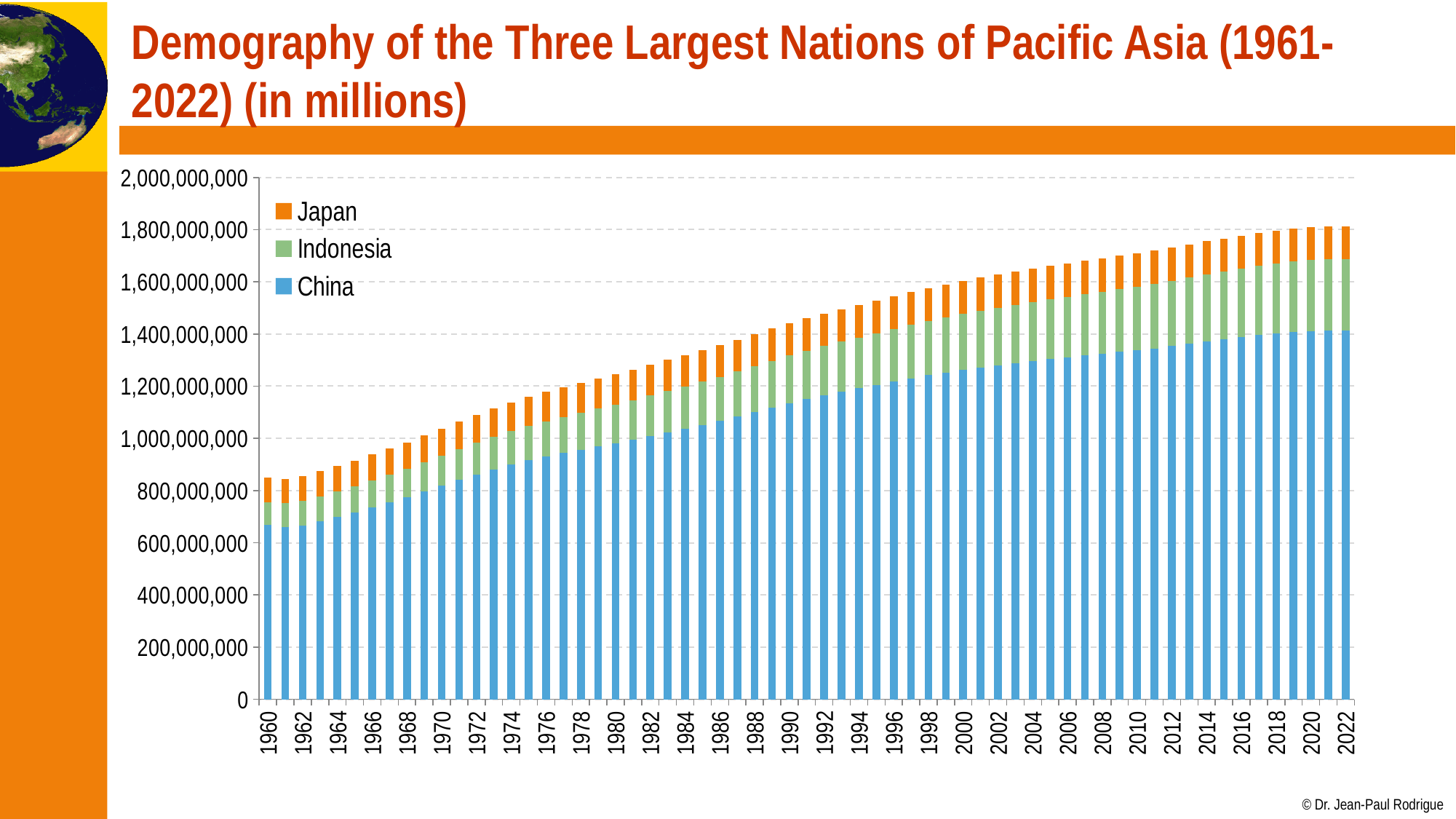
Which three countries are listed in the legend? Japan, Indonesia, China Which colour represents China in the chart? Blue Is the total stacked value for 2022 greater or less than 2,000,000,000? less Is the value for China in 1960 greater or less than 800,000,000? less Is the value for China in 1990 greater or less than 1,000,000,000? greater Do the total stacked values rise or fall from 1960 to 2022? Rise What kind of chart is shown on the slide? Stacked bar chart Which country accounts for the largest segment of each stacked bar? China How many series does the legend list? 3